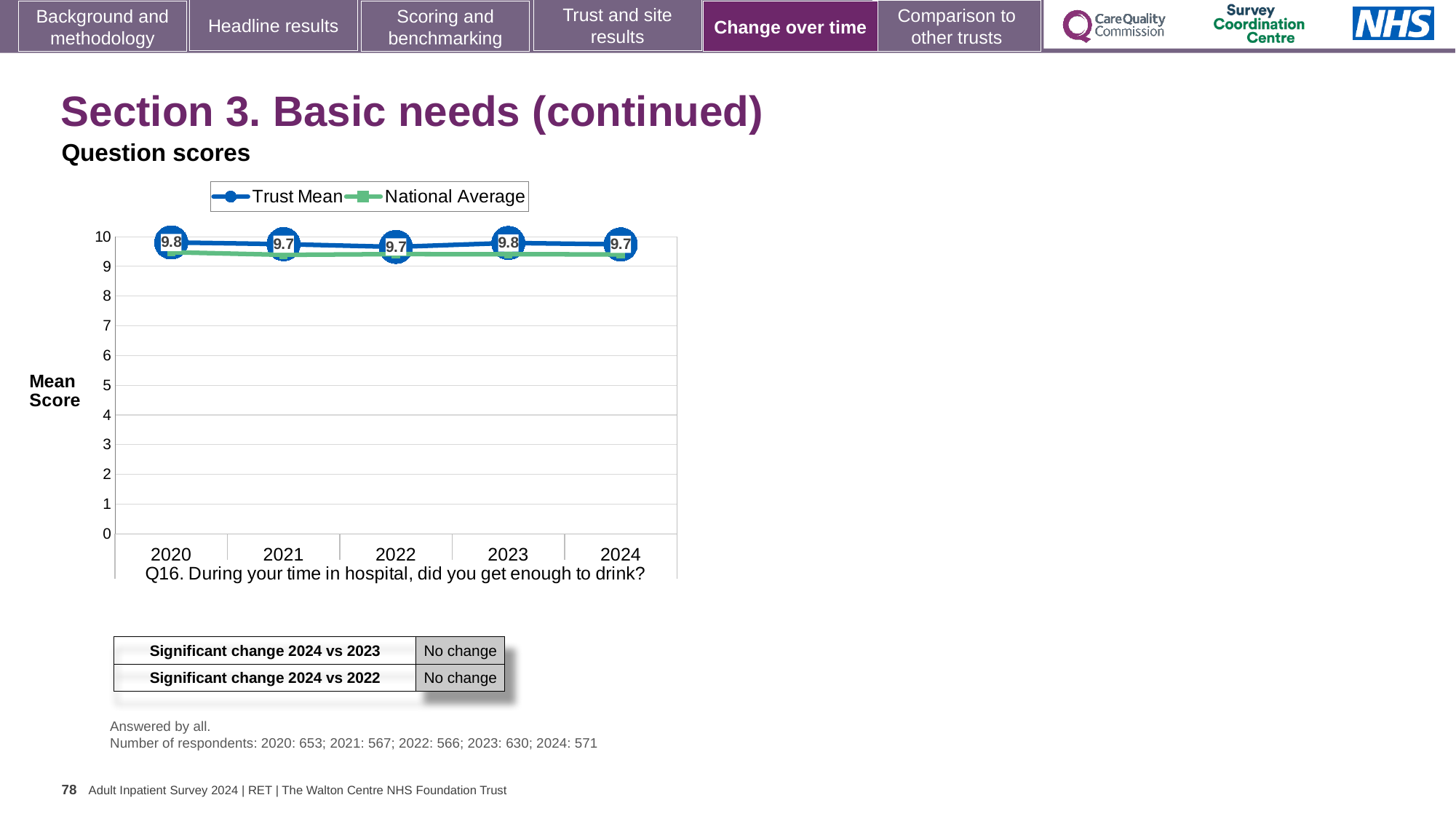
In 2020, which series has the higher value, Trust Mean or National Average? Trust Mean How many series does the chart legend list? 2 What is the Trust Mean score for 2020? 9.8 What kind of chart is shown on the slide? Line chart What is the Trust Mean score for 2024? 9.7 What is the Trust Mean score for 2023? 9.8 How many years are shown on the x axis of the chart? 5 Does the Trust Mean rise or fall from 2023 to 2024? Fall What is the Trust Mean score for 2022? 9.7 Is the Trust Mean value for 2021 greater or less than 5? greater Is the National Average value for 2024 greater or less than 9? greater What is the difference between the Trust Mean scores for 2020 and 2021? 0.1